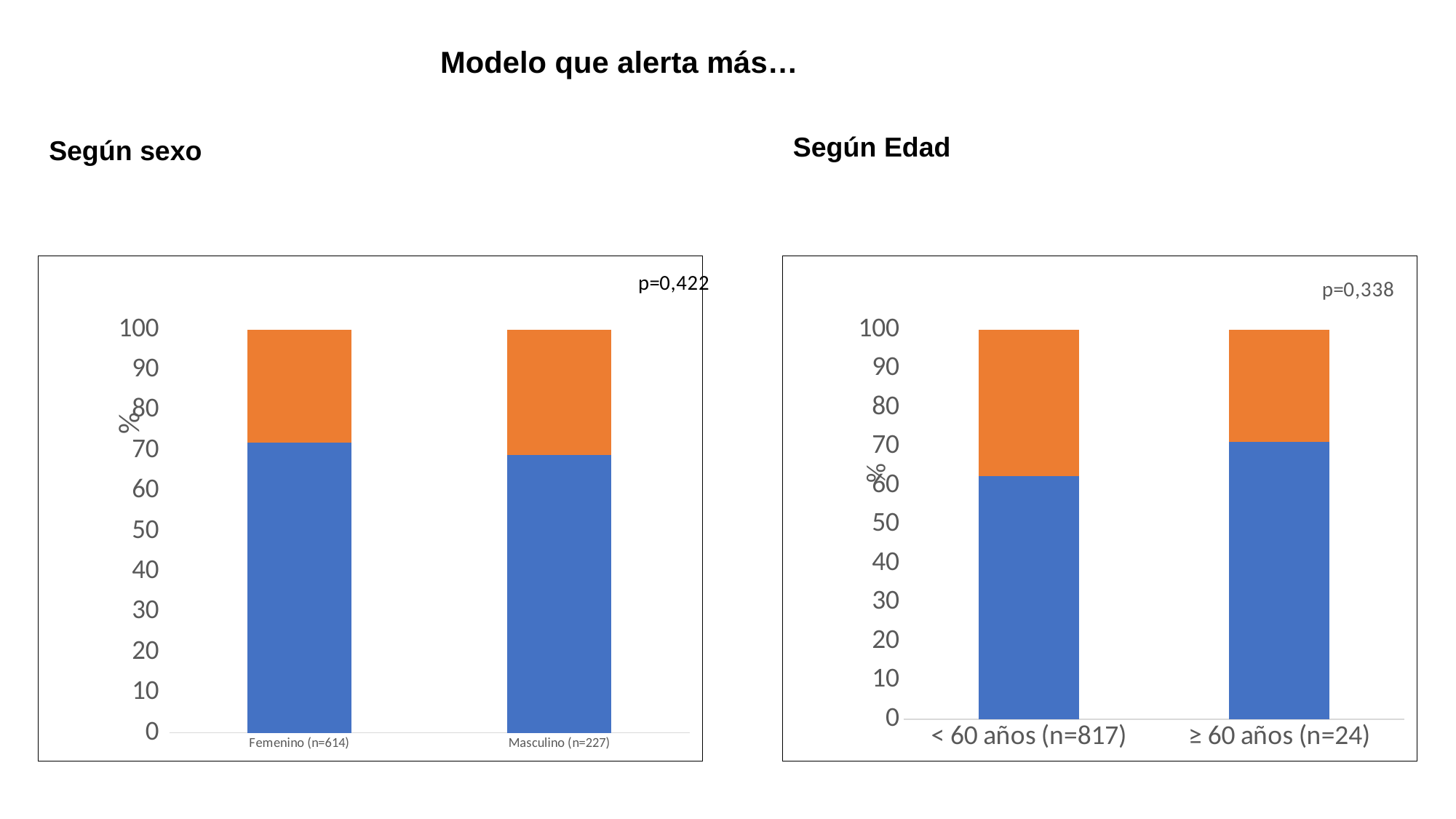
In the 'Según Edad' chart, which category has the larger blue segment, < 60 años (n=817) or ≥ 60 años (n=24)? ≥ 60 años (n=24) In the 'Según sexo' chart, is the blue segment for Femenino (n=614) greater or less than 80? less What p-value is printed on the 'Según Edad' chart? p=0,338 In the 'Según Edad' chart, is the blue segment for ≥ 60 años (n=24) greater or less than 60? greater What kind of chart is the 'Según sexo' chart? bar chart In the 'Según sexo' chart, what is the total height of the stacked bar for Femenino (n=614)? 100 What p-value is printed on the 'Según sexo' chart? p=0,422 How many categories are shown on the x axis of the 'Según sexo' chart? 2 In the 'Según Edad' chart, is the blue segment for < 60 años (n=817) greater or less than 70? less How many categories are shown on the x axis of the 'Según Edad' chart? 2 In the 'Según Edad' chart, which category has the larger orange segment, < 60 años (n=817) or ≥ 60 años (n=24)? < 60 años (n=817)